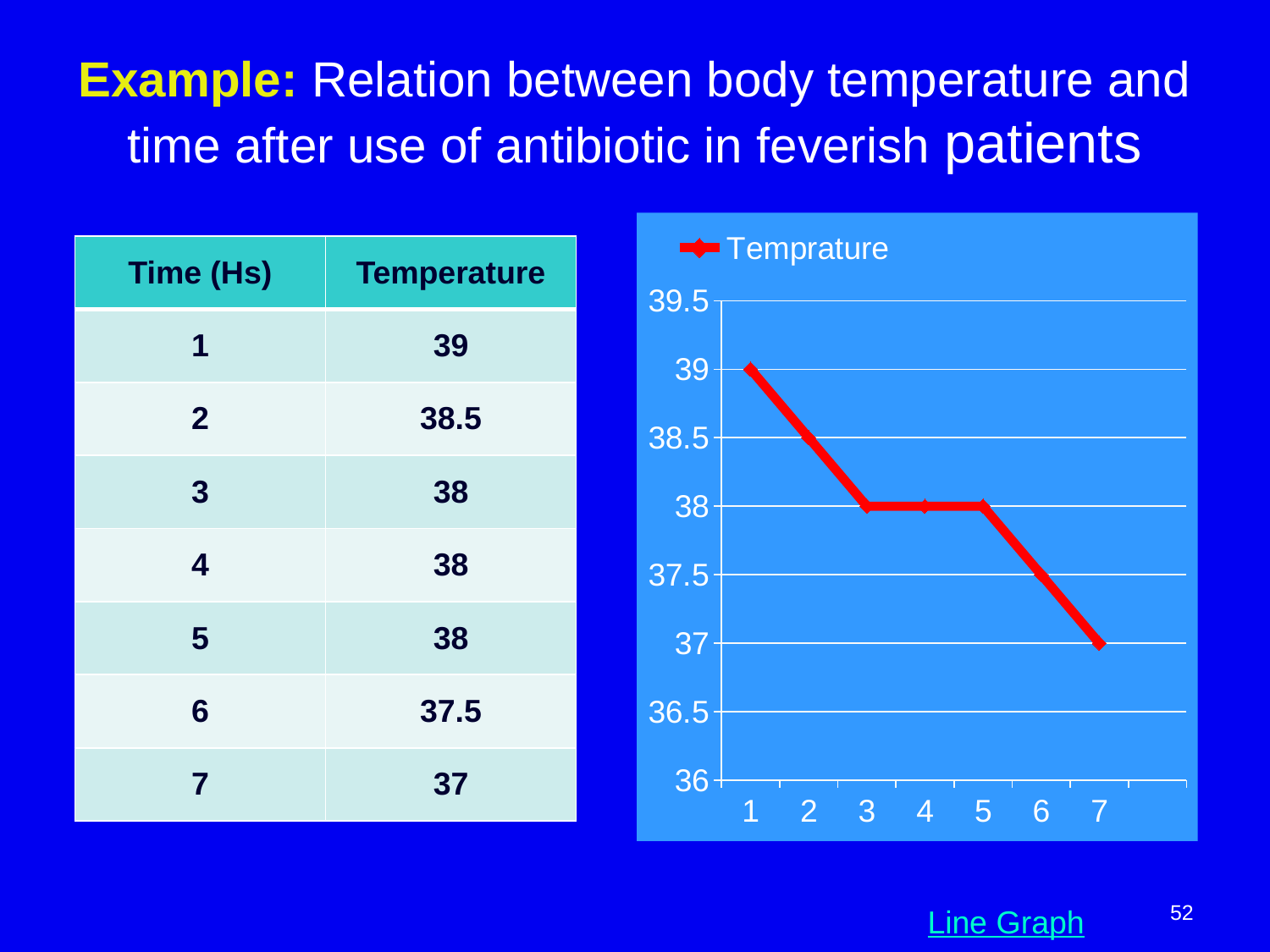
What is the temperature at time 1 on the line chart? 39 How many time points are plotted on the line chart? 7 Does the temperature rise or fall as time increases along the x axis? fall What is the temperature at time 4 on the line chart? 38 Which is larger, the temperature at time 2 or at time 6? time 2 What is the temperature at time 6 on the line chart? 37.5 At which time is the temperature highest on the line chart? 1 What series name does the legend of the line chart show? Temprature What kind of chart is shown on the slide? line chart At which time is the temperature lowest on the line chart? 7 What is the temperature at time 7 on the line chart? 37 What is the difference between the temperature at time 1 and at time 7? 2